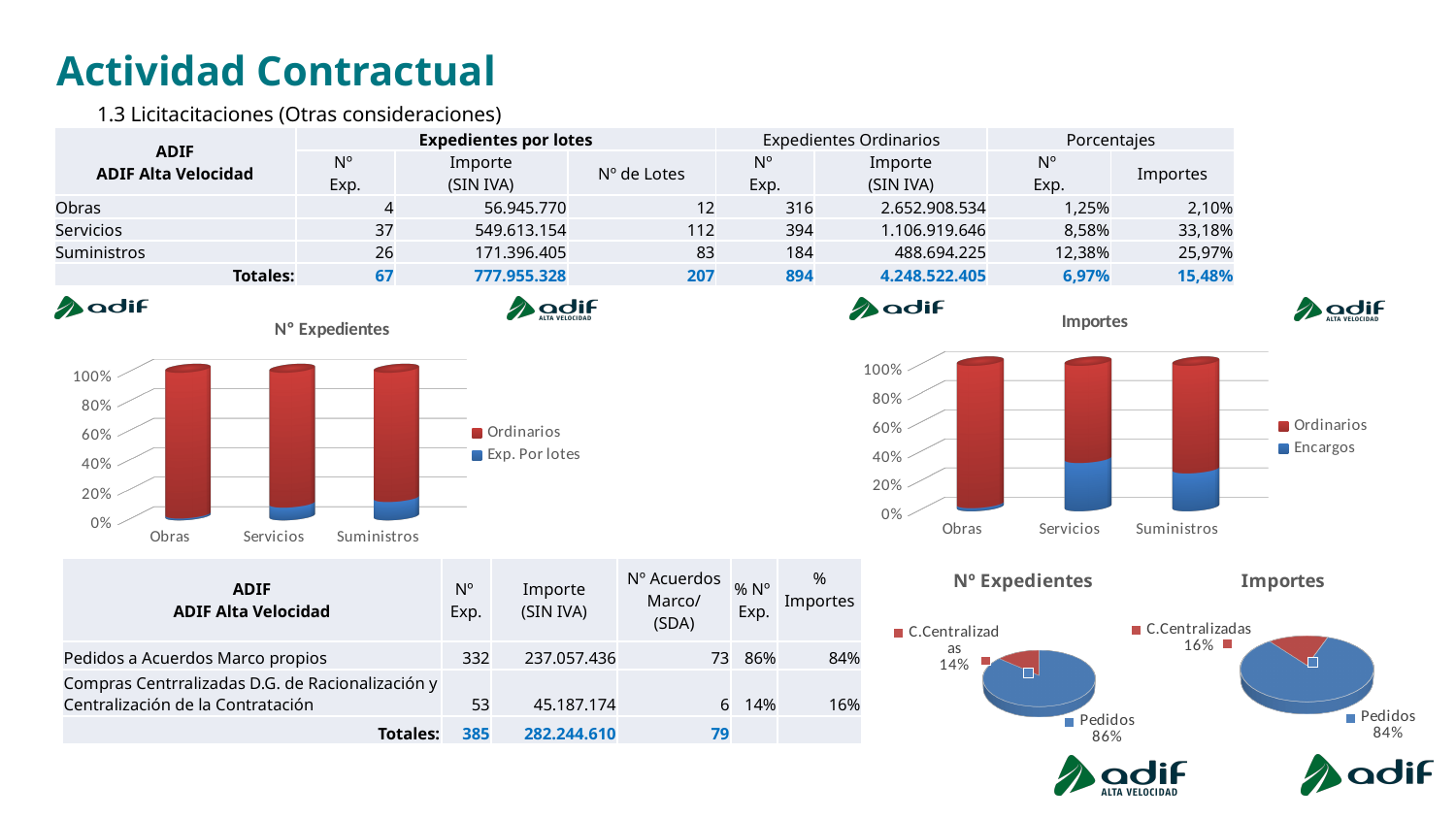
In the 'Nº Expedientes' pie chart at the bottom of the slide, what share is labelled for Pedidos? 86% In the 'Importes' bar chart at the top right, is the Encargos value for Obras greater or less than 20%? less What kind of chart is the 'Importes' chart at the top right of the slide? bar chart In the 'Nº Expedientes' pie chart at the bottom, what is the difference between the Pedidos share and the C.Centralizadas share? 72% In the 'Importes' pie chart at the bottom right of the slide, what share is labelled for C.Centralizadas? 16% In the 'Importes' bar chart at the top right, is the Encargos value for Servicios greater or less than 20%? greater In the 'Importes' pie chart at the bottom right of the slide, what share is labelled for Pedidos? 84% In the 'Nº Expedientes' pie chart at the bottom of the slide, what share is labelled for C.Centralizadas? 14% How many series does the legend of the 'Importes' bar chart at the top right list? 2 What are the two legend entries of the 'Nº Expedientes' bar chart at the top left? Ordinarios and Exp. Por lotes How many categories are shown on the x axis of the 'Nº Expedientes' bar chart at the top left? 3 In the 'Importes' pie chart at the bottom right, which slice is larger, Pedidos or C.Centralizadas? Pedidos